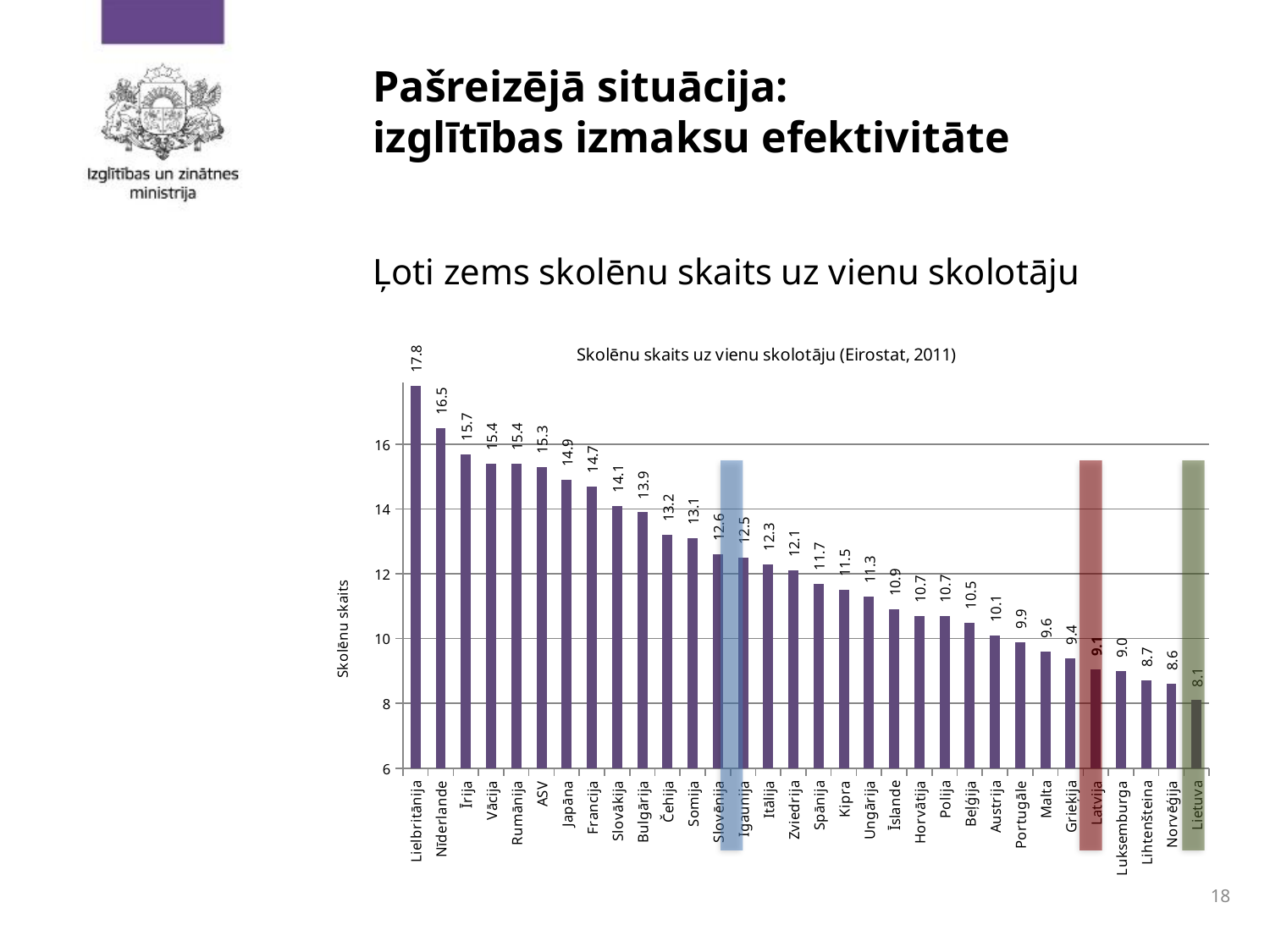
What is the value for Latvija? 9.1 Do the values rise or fall from left to right along the x axis? Fall What is the value for Igaunija? 12.5 What kind of chart is shown on the slide? Bar chart Which country has the lowest number of pupils per teacher? Lietuva What is the value for Lietuva? 8.1 Which is larger, the value for Igaunija or the value for Latvija? Igaunija What is the title of the chart? Skolēnu skaits uz vienu skolotāju (Eirostat, 2011) How many countries are shown in the chart? 32 Which country has the highest number of pupils per teacher? Lielbritānija Is the value for Nīderlande greater or less than 16? greater What is the difference between the values for Lielbritānija and Latvija? 8.7